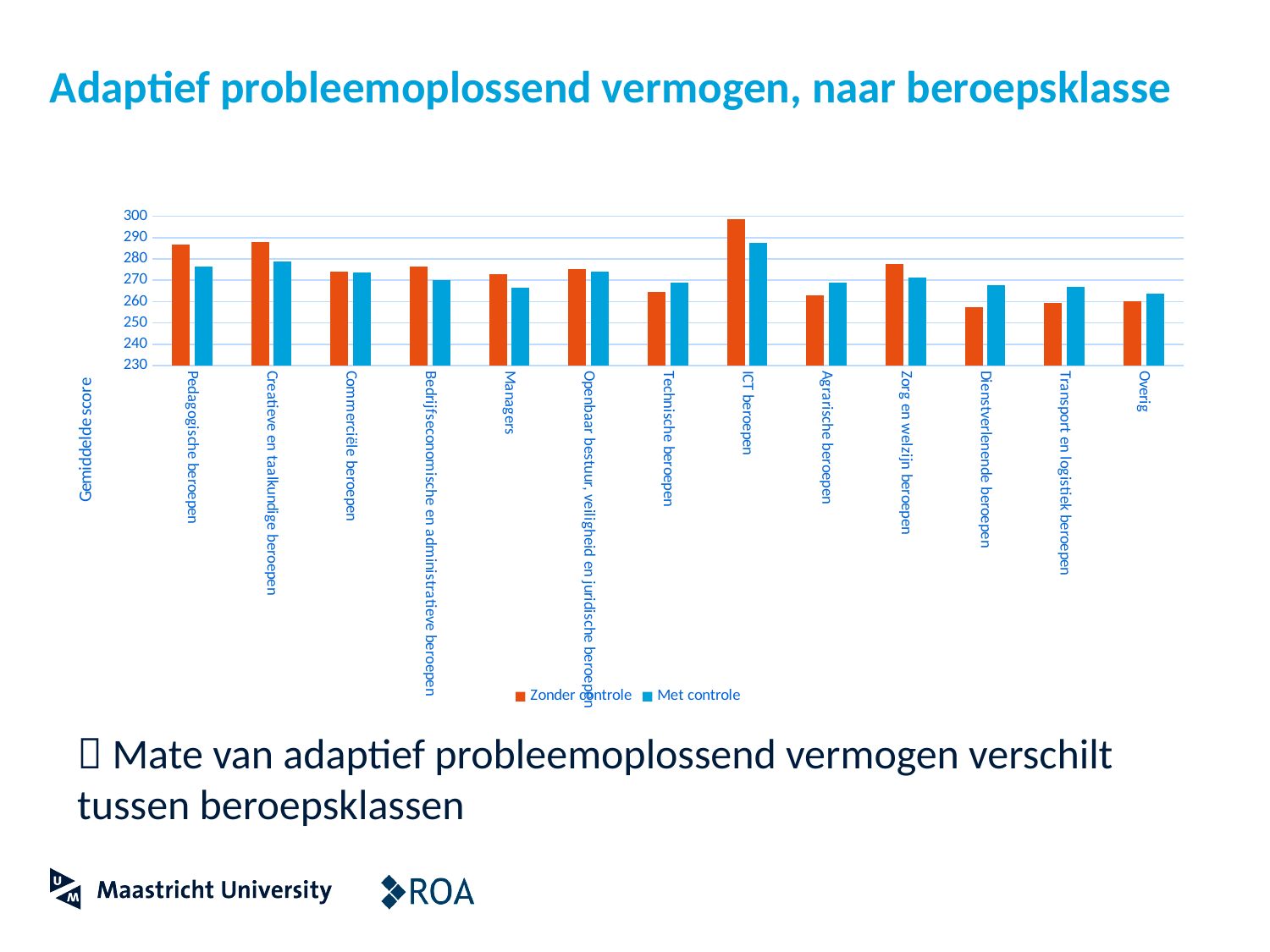
For Technische beroepen, which series has the larger value: 'Zonder controle' or 'Met controle'? Met controle What is the label of the y axis? Gemiddelde score Is the 'Zonder controle' value for Dienstverlenende beroepen greater or less than 260? less How many series does the legend list? 2 Which category has the highest value for the 'Met controle' series? ICT beroepen Which category has the lowest value for the 'Zonder controle' series? Dienstverlenende beroepen Is the 'Zonder controle' value for Pedagogische beroepen greater or less than 280? greater Is the 'Zonder controle' value for ICT beroepen greater or less than 290? greater How many occupational classes (categories) are shown on the x axis? 13 Which category has the highest value for the 'Zonder controle' series? ICT beroepen For Pedagogische beroepen, which series has the larger value: 'Zonder controle' or 'Met controle'? Zonder controle What kind of chart is shown on the slide? bar chart